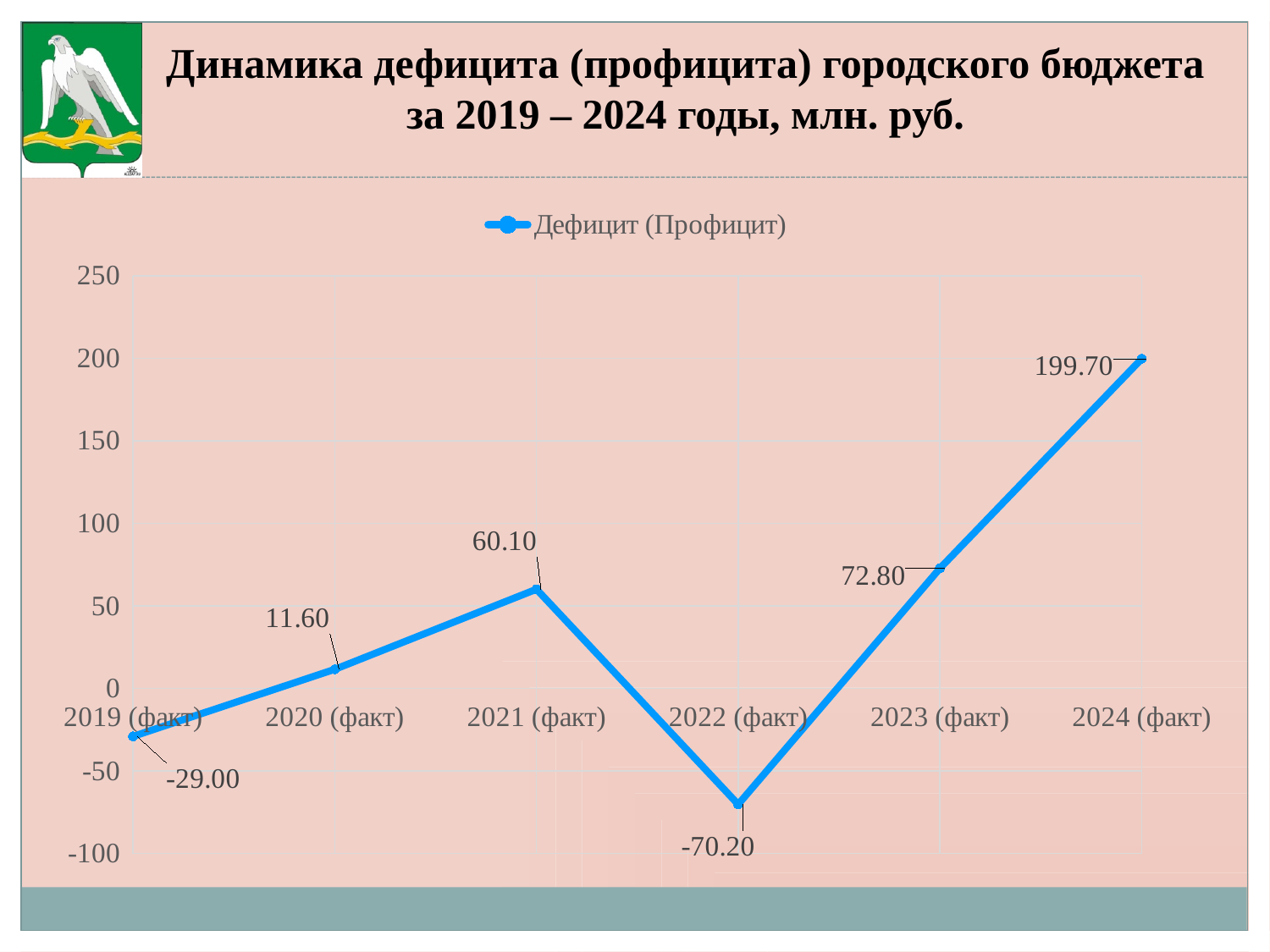
What is the difference between the values for 2024 (факт) and 2023 (факт)? 126.90 How many years are plotted on the chart? 6 What is the name of the series shown in the legend? Дефицит (Профицит) Which year has the highest value? 2024 (факт) What is the value for 2019 (факт)? -29.00 What is the value for 2021 (факт)? 60.10 What kind of chart is shown? line chart Is the value for 2023 (факт) greater or less than 50? greater How many series does the legend list? 1 Which is larger, the value for 2020 (факт) or the value for 2021 (факт)? 2021 (факт) Which year has the lowest value? 2022 (факт) What is the value for 2024 (факт)? 199.70